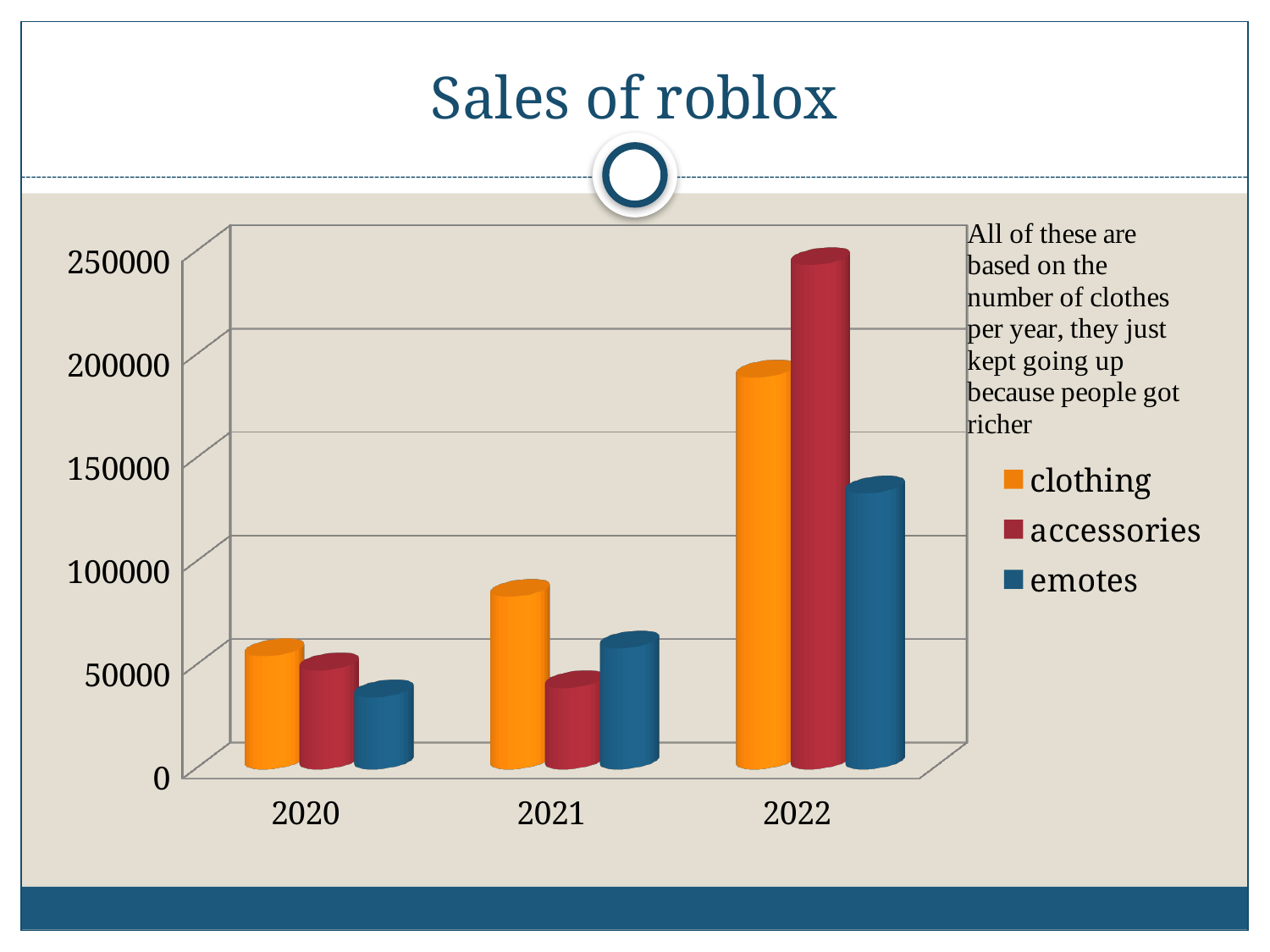
Do the clothing values rise or fall from 2020 to 2022? rise In 2021, which is larger: clothing or emotes? clothing Is the value for clothing in 2022 greater or less than 150000? greater Is the value for accessories in 2022 greater or less than 200000? greater Is the value for emotes in 2020 greater or less than 50000? less Which series has the lowest bar in 2021? accessories What is the title of the chart? Sales of roblox Which series has the tallest bar in 2022? accessories What kind of chart is shown on the slide? bar chart Which series has the lowest bar in 2020? emotes How many years are shown on the x axis? 3 How many series does the legend list? 3